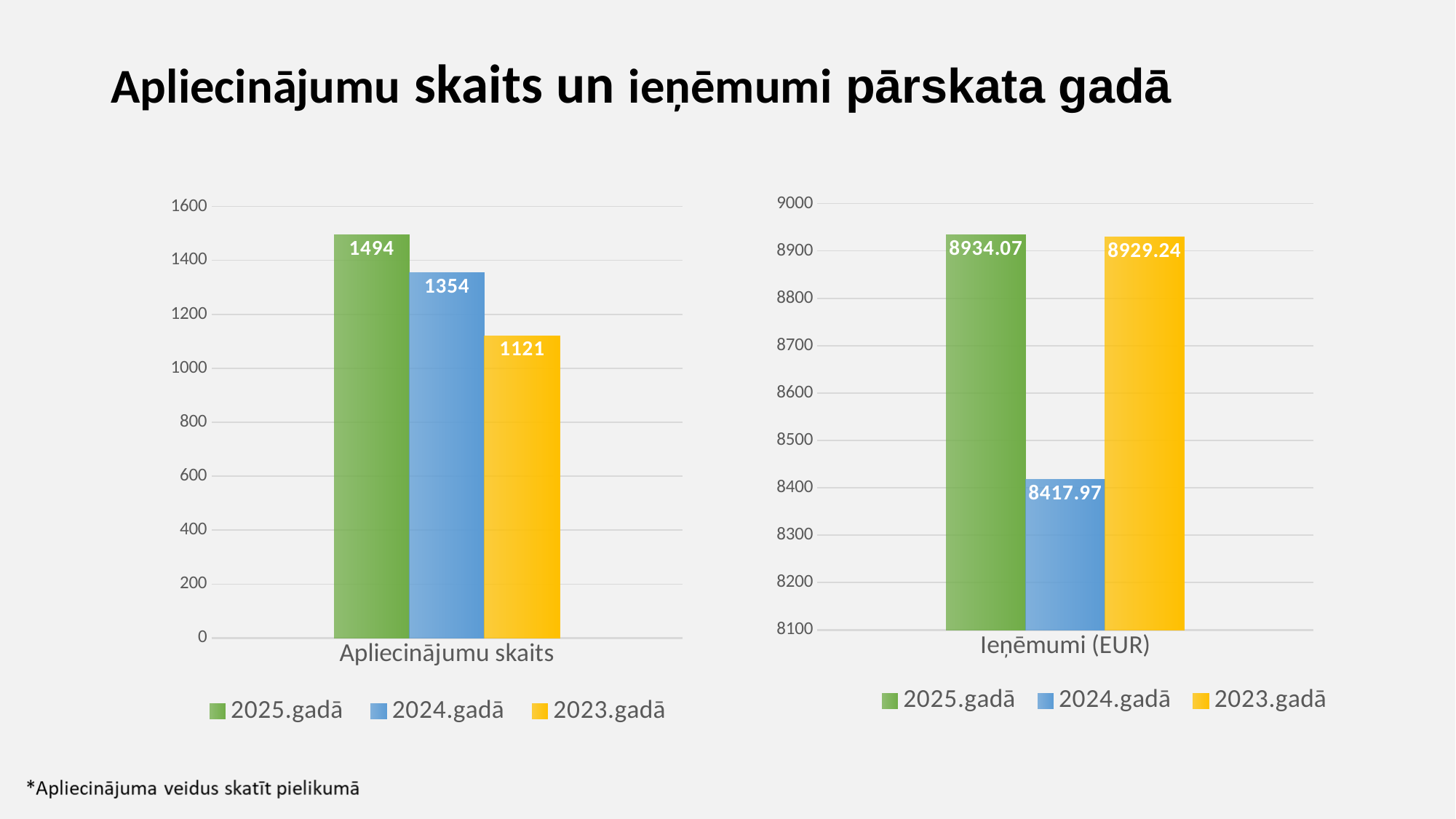
In the left chart (Apliecinājumu skaits), which year has the highest value? 2025.gadā What kind of chart is the right chart (Ieņēmumi (EUR))? bar chart In the right chart (Ieņēmumi (EUR)), what is the value for 2025.gadā? 8934.07 In the right chart (Ieņēmumi (EUR)), what is the difference between the 2023.gadā and 2024.gadā values? 511.27 In the left chart (Apliecinājumu skaits), what is the value for 2025.gadā? 1494 In the left chart (Apliecinājumu skaits), which is larger, the value for 2024.gadā or 2023.gadā? 2024.gadā In the left chart (Apliecinājumu skaits), what is the value for 2023.gadā? 1121 In the right chart (Ieņēmumi (EUR)), what is the value for 2024.gadā? 8417.97 In the right chart (Ieņēmumi (EUR)), which year has the lowest value? 2024.gadā How many series does the legend of the left chart (Apliecinājumu skaits) list? 3 In the right chart (Ieņēmumi (EUR)), is the value for 2024.gadā greater or less than 8500? less In the left chart (Apliecinājumu skaits), what is the difference between the 2025.gadā and 2024.gadā values? 140